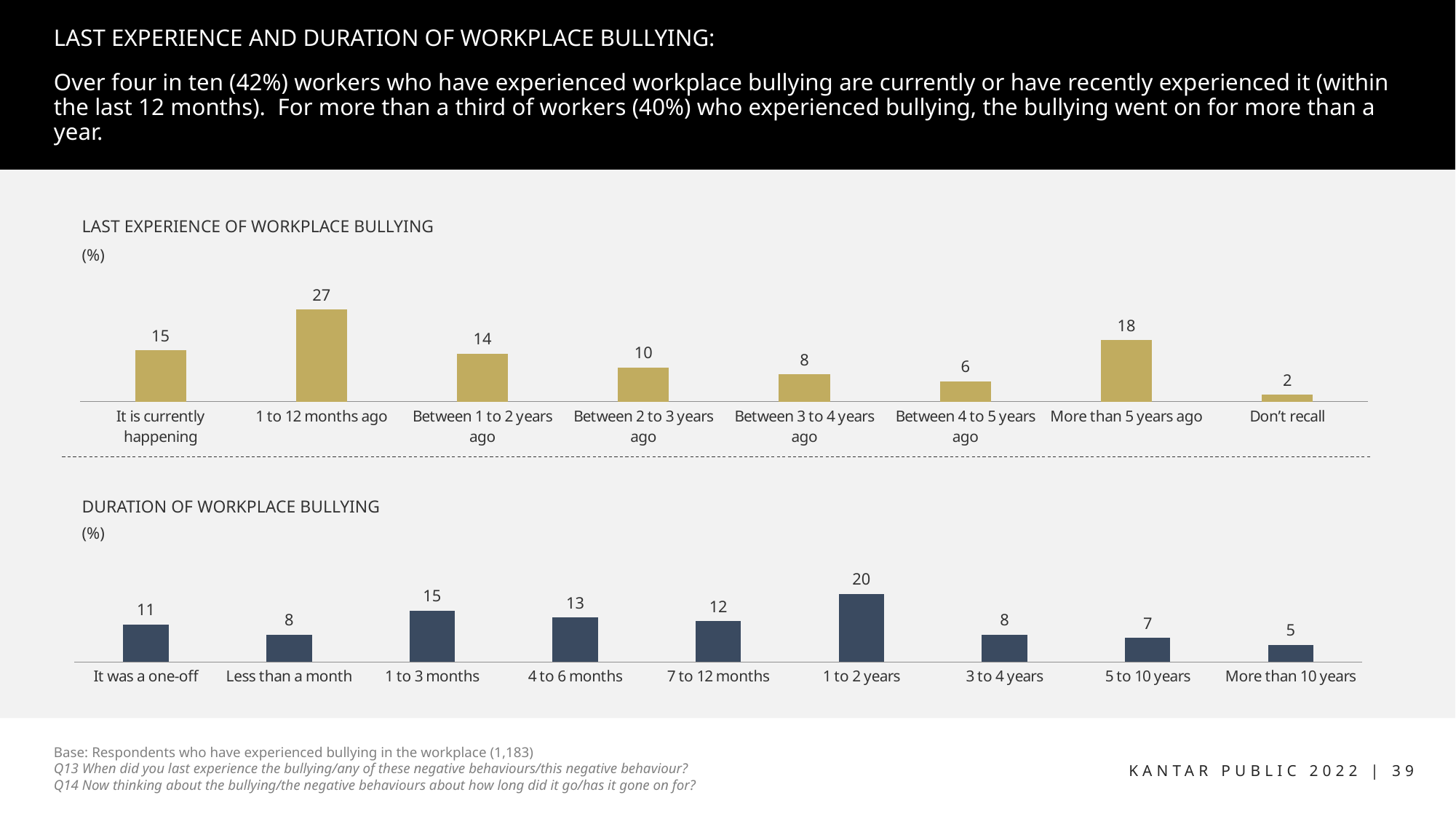
What colour are the bars in the 'Last experience of workplace bullying' chart? Gold In the 'Duration of workplace bullying' chart, what is the difference between '1 to 3 months' and 'Less than a month'? 7 In the 'Duration of workplace bullying' chart, which category has the lowest value? More than 10 years In the 'Last experience of workplace bullying' chart, which is larger: 'It is currently happening' or 'Between 1 to 2 years ago'? It is currently happening In the 'Last experience of workplace bullying' chart, which category has the lowest value? Don't recall In the 'Duration of workplace bullying' chart, how many categories are shown? 9 In the 'Duration of workplace bullying' chart, what is the value for '1 to 2 years'? 20 In the 'Last experience of workplace bullying' chart, what is the value for '1 to 12 months ago'? 27 What type of chart is the 'Duration of workplace bullying' chart? Bar chart In the 'Last experience of workplace bullying' chart, what is the difference between 'More than 5 years ago' and 'Between 4 to 5 years ago'? 12 In the 'Last experience of workplace bullying' chart, how many categories are shown? 8 In the 'Duration of workplace bullying' chart, which category has the highest value? 1 to 2 years